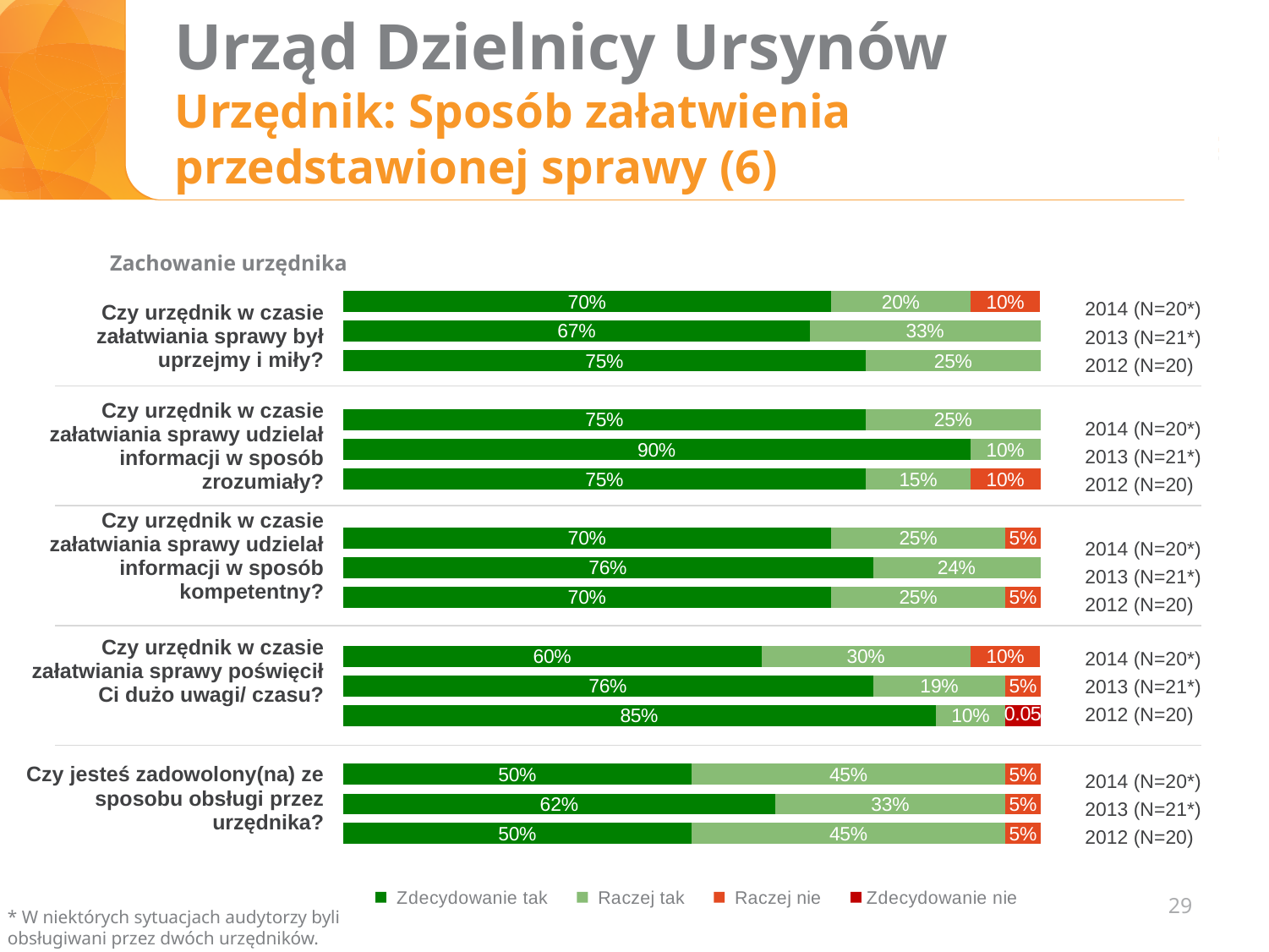
What kind of chart is shown on the slide? Stacked bar chart For the question "Czy urzędnik w czasie załatwiania sprawy poświęcił Ci dużo uwagi/ czasu?", which year has the lowest share of "Zdecydowanie tak"? 2014 What percentage answered "Raczej tak" in 2014 to the question "Czy urzędnik w czasie załatwiania sprawy poświęcił Ci dużo uwagi/ czasu?"? 30% What percentage answered "Zdecydowanie tak" in 2012 to the question "Czy urzędnik w czasie załatwiania sprawy poświęcił Ci dużo uwagi/ czasu?"? 85% For the question "Czy urzędnik w czasie załatwiania sprawy był uprzejmy i miły?", which year has the larger "Zdecydowanie tak" share, 2012 or 2013? 2012 How many answer categories does the legend list? 4 For the question "Czy jesteś zadowolony(na) ze sposobu obsługi przez urzędnika?", how many percentage points higher is the "Zdecydowanie tak" share in 2013 than in 2014? 12 percentage points What percentage answered "Zdecydowanie tak" in 2014 to the question "Czy urzędnik w czasie załatwiania sprawy był uprzejmy i miły?"? 70% What percentage answered "Zdecydowanie tak" in 2013 to the question "Czy urzędnik w czasie załatwiania sprawy udzielał informacji w sposób zrozumiały?"? 90% For the question "Czy urzędnik w czasie załatwiania sprawy udzielał informacji w sposób zrozumiały?", which year has the highest share of "Zdecydowanie tak"? 2013 How many survey questions are shown in the chart? 5 What percentage answered "Raczej nie" in 2014 to the question "Czy urzędnik w czasie załatwiania sprawy był uprzejmy i miły?"? 10%